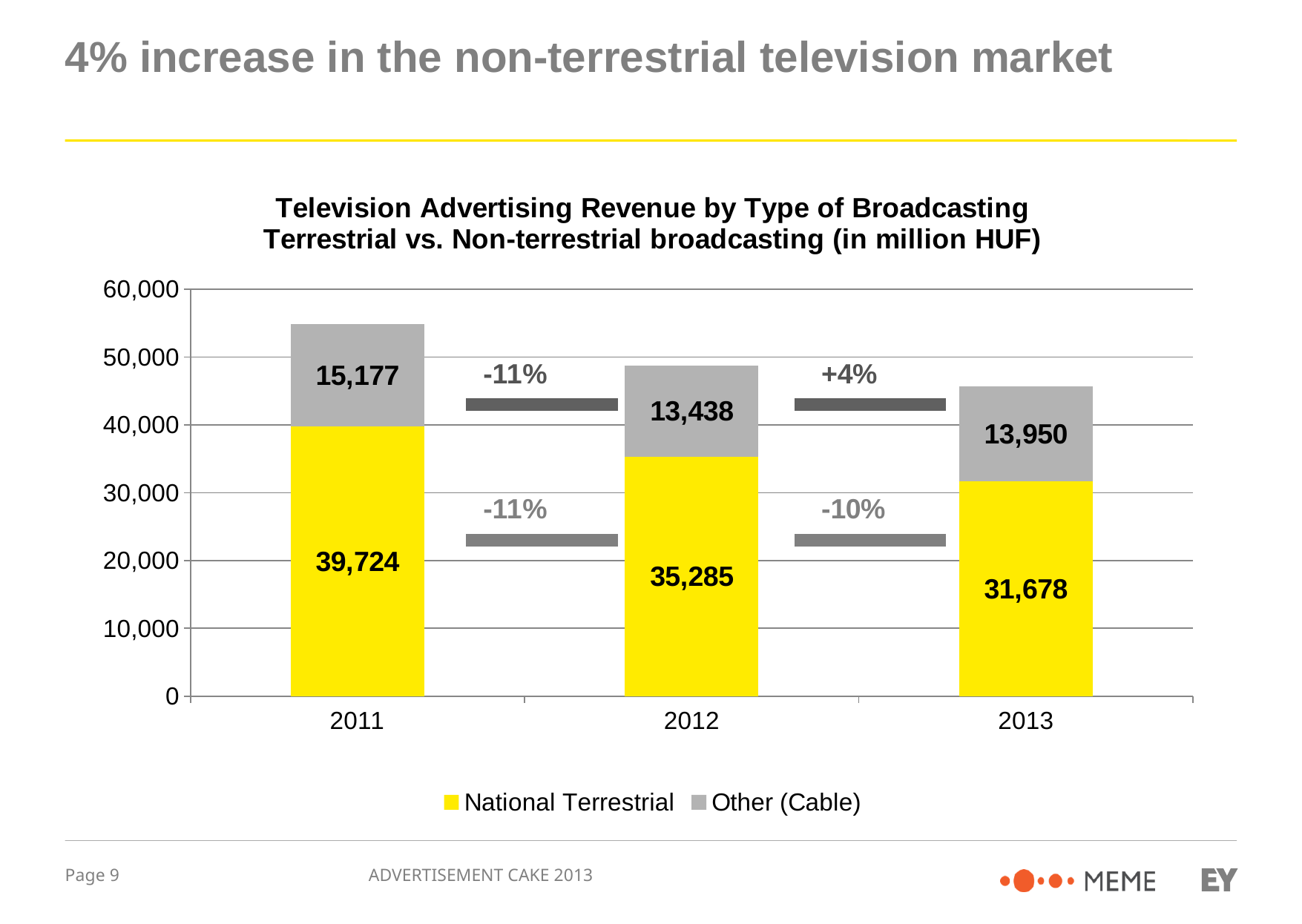
Which year has the lowest Other (Cable) value? 2012 What is the difference between the Other (Cable) values for 2013 and 2012? 512 Which is larger: the Other (Cable) value for 2011 or for 2013? 2011 What is the National Terrestrial value for 2011? 39,724 How many years are shown on the x axis? 3 What is the total of the stacked bar for 2011? 54,901 What is the total of the stacked bar for 2013? 45,628 What is the difference between the National Terrestrial values for 2011 and 2012? 4,439 How many series does the legend list? 2 Which year has the highest National Terrestrial value? 2011 What is the Other (Cable) value for 2013? 13,950 What is the National Terrestrial value for 2012? 35,285